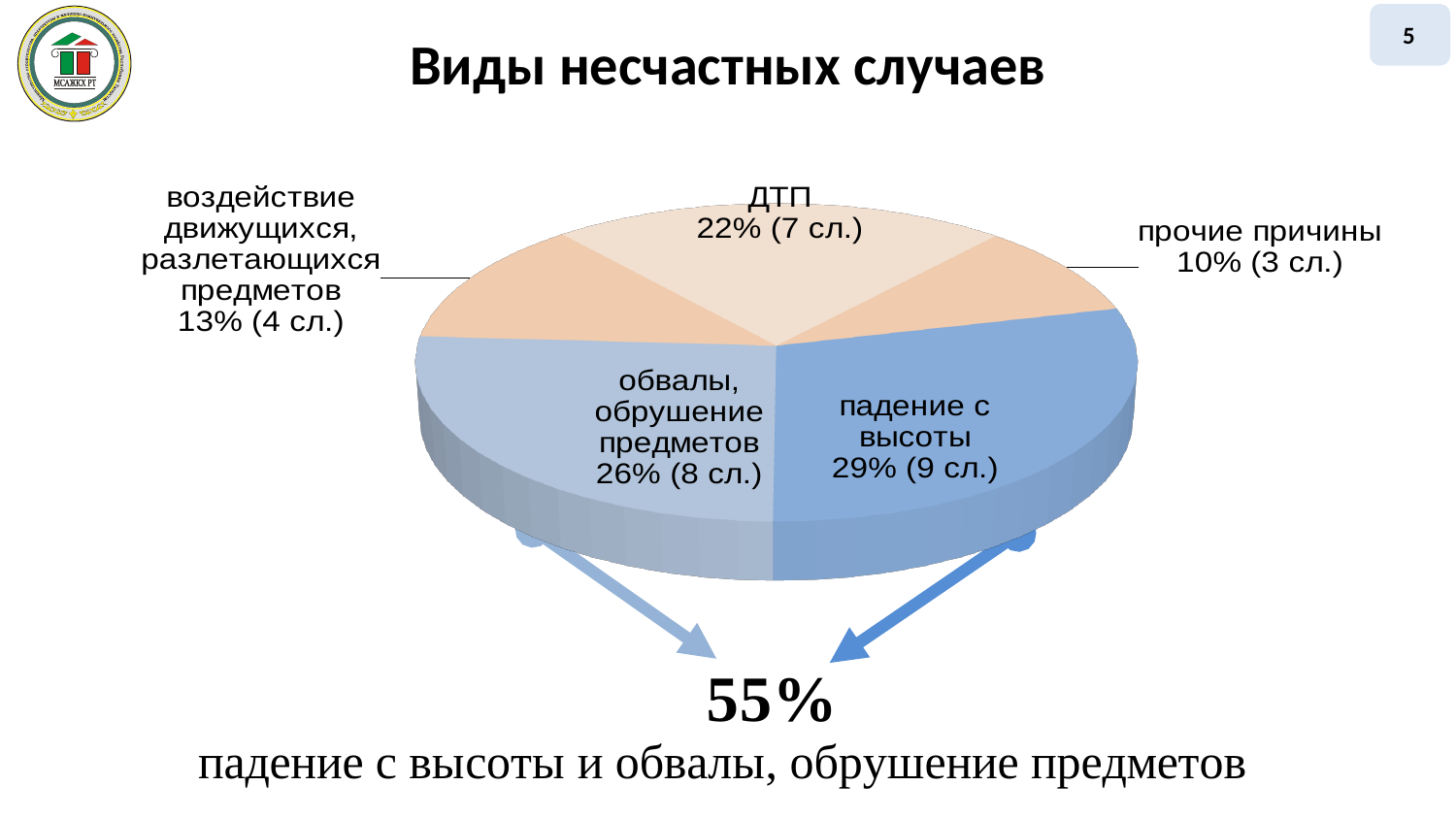
Which category has the smallest share of the pie? прочие причины What percentage is shown for "обвалы, обрушение предметов"? 26% How many cases (сл.) are shown for "ДТП"? 7 сл. What is the difference in percentage points between "падение с высоты" and "прочие причины"? 19 Which category has the largest share of the pie? падение с высоты What is the title of the chart? Виды несчастных случаев Which is larger: the share for "ДТП" or the share for "воздействие движущихся, разлетающихся предметов"? ДТП What combined percentage is highlighted below the chart for "падение с высоты" and "обвалы, обрушение предметов"? 55% What type of chart is shown on the slide? Pie chart How many cases are shown for "прочие причины"? 3 сл. What share of the pie does "падение с высоты" represent? 29% How many slices does the pie chart have? 5